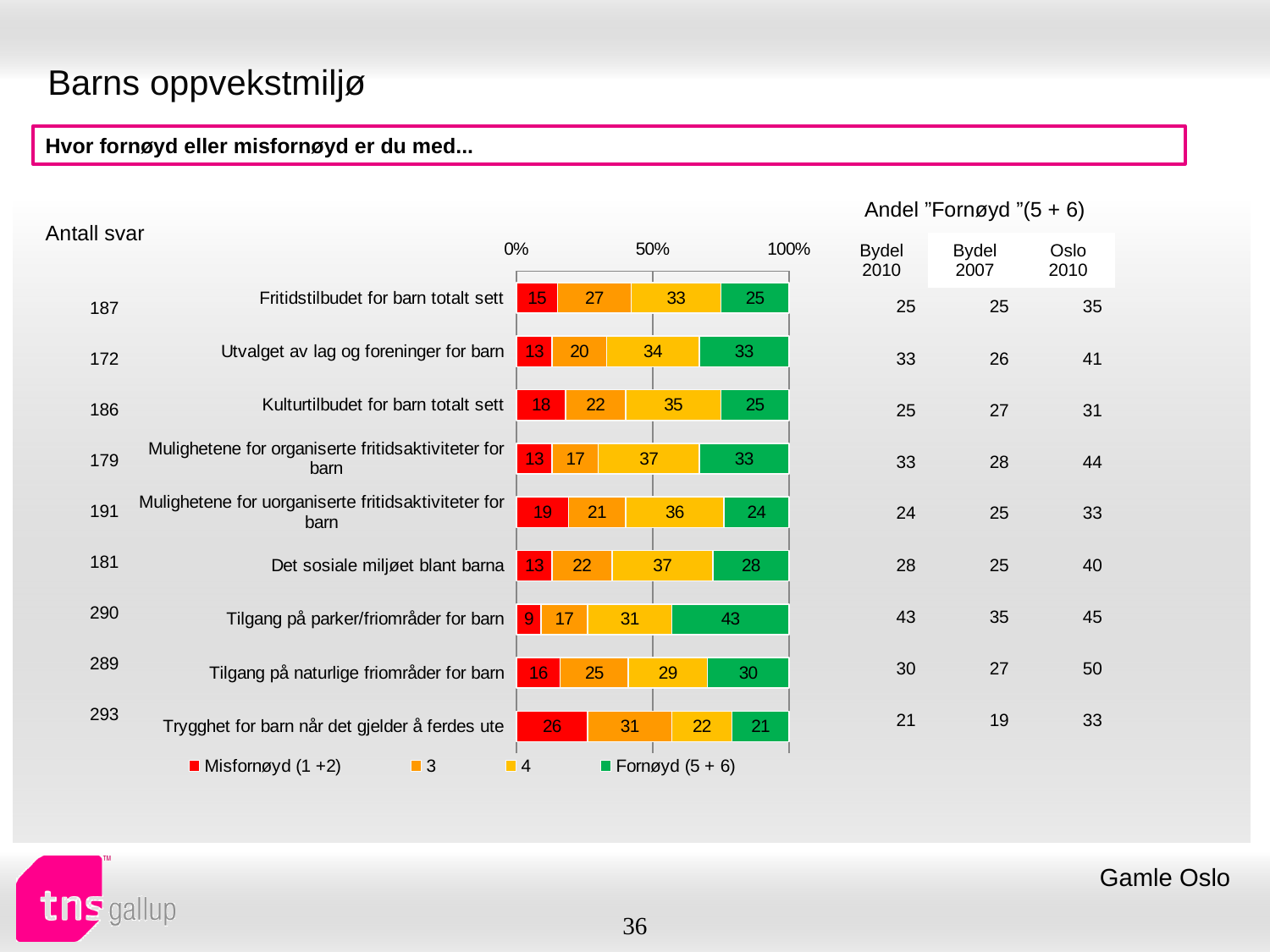
What kind of chart is shown on the slide? Stacked bar chart What is the value of series '4' for 'Mulighetene for organiserte fritidsaktiviteter for barn'? 37 What is the label of the first series in the chart legend? Misfornøyd (1 +2) Which has a larger 'Misfornøyd (1 +2)' value: 'Kulturtilbudet for barn totalt sett' or 'Utvalget av lag og foreninger for barn'? Kulturtilbudet for barn totalt sett Which category has the lowest 'Misfornøyd (1 +2)' value? Tilgang på parker/friområder for barn What is the 'Misfornøyd (1 +2)' value for 'Trygghet for barn når det gjelder å ferdes ute'? 26 What is the 'Fornøyd (5 + 6)' value for 'Tilgang på parker/friområder for barn'? 43 Which category has the highest 'Fornøyd (5 + 6)' value? Tilgang på parker/friområder for barn How many categories (survey items) are plotted in the chart? 9 What is the total of the stacked bar for 'Fritidstilbudet for barn totalt sett'? 100 How many series does the chart legend list? 4 What is the difference between the 'Fornøyd (5 + 6)' values for 'Tilgang på parker/friområder for barn' and 'Trygghet for barn når det gjelder å ferdes ute'? 22